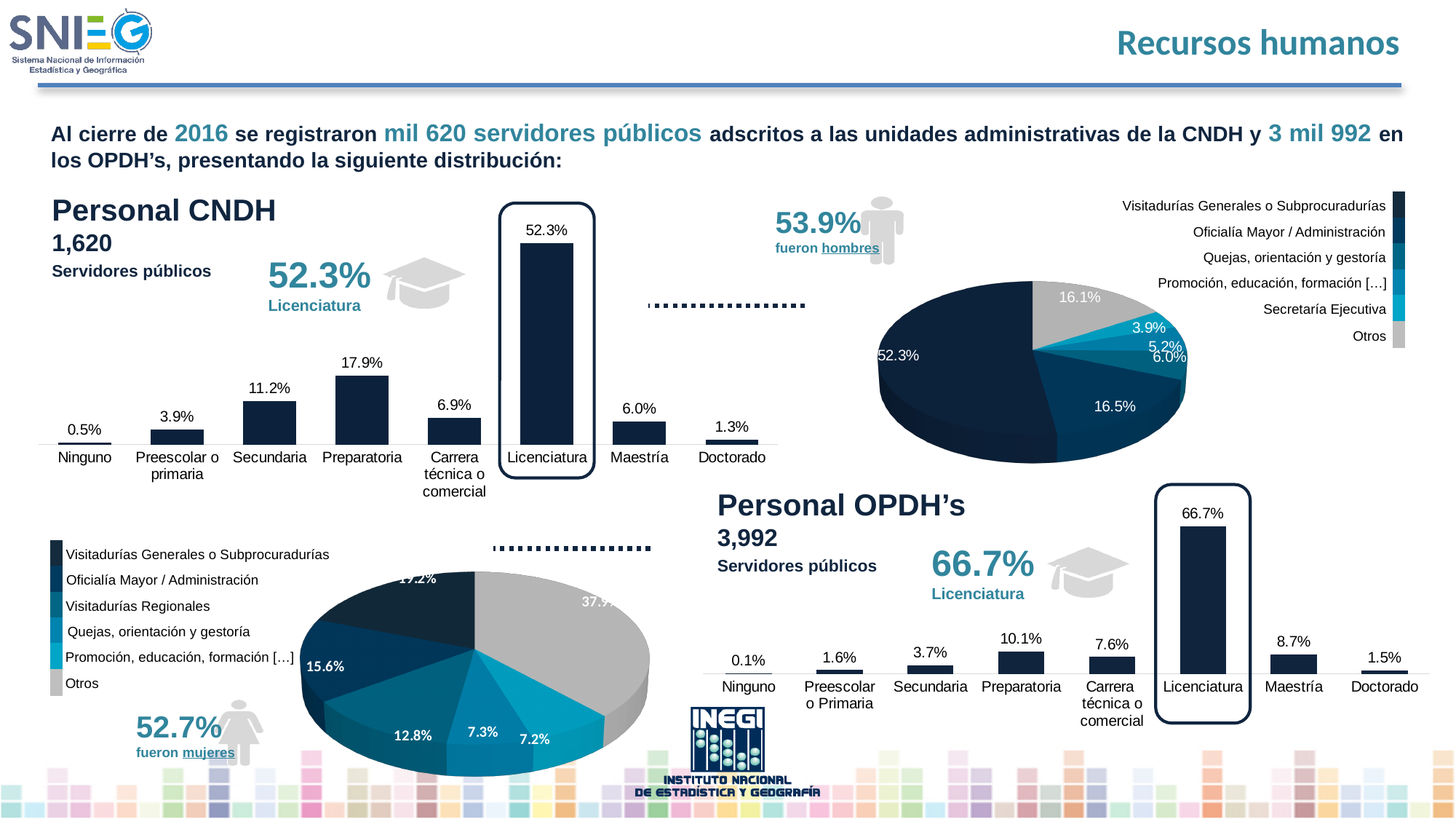
How many categories are shown in the Personal CNDH bar chart? 8 In the Personal CNDH bar chart, what percentage is shown for Licenciatura? 52.3% In the Personal OPDH's bar chart, which is larger: Maestría or Carrera técnica o comercial? Maestría In the Personal CNDH bar chart, what is the difference between Maestría and Doctorado? 4.7 percentage points In the Personal CNDH bar chart, which category has the lowest value? Ninguno In the Personal OPDH's bar chart, what is the difference between Preparatoria and Secundaria? 6.4 percentage points In the Personal OPDH's bar chart, what is the value for Ninguno? 0.1% How many entries does the legend of the pie chart at the bottom left (OPDH's by administrative unit) list? 6 In the pie chart at the top right (CNDH by administrative unit), what share is labelled for the gray Otros slice? 16.1% In the Personal OPDH's bar chart, what percentage is shown for Licenciatura? 66.7% What type of chart is the Personal CNDH chart showing education levels? Bar chart In the Personal CNDH bar chart, what is the value for Preparatoria? 17.9%